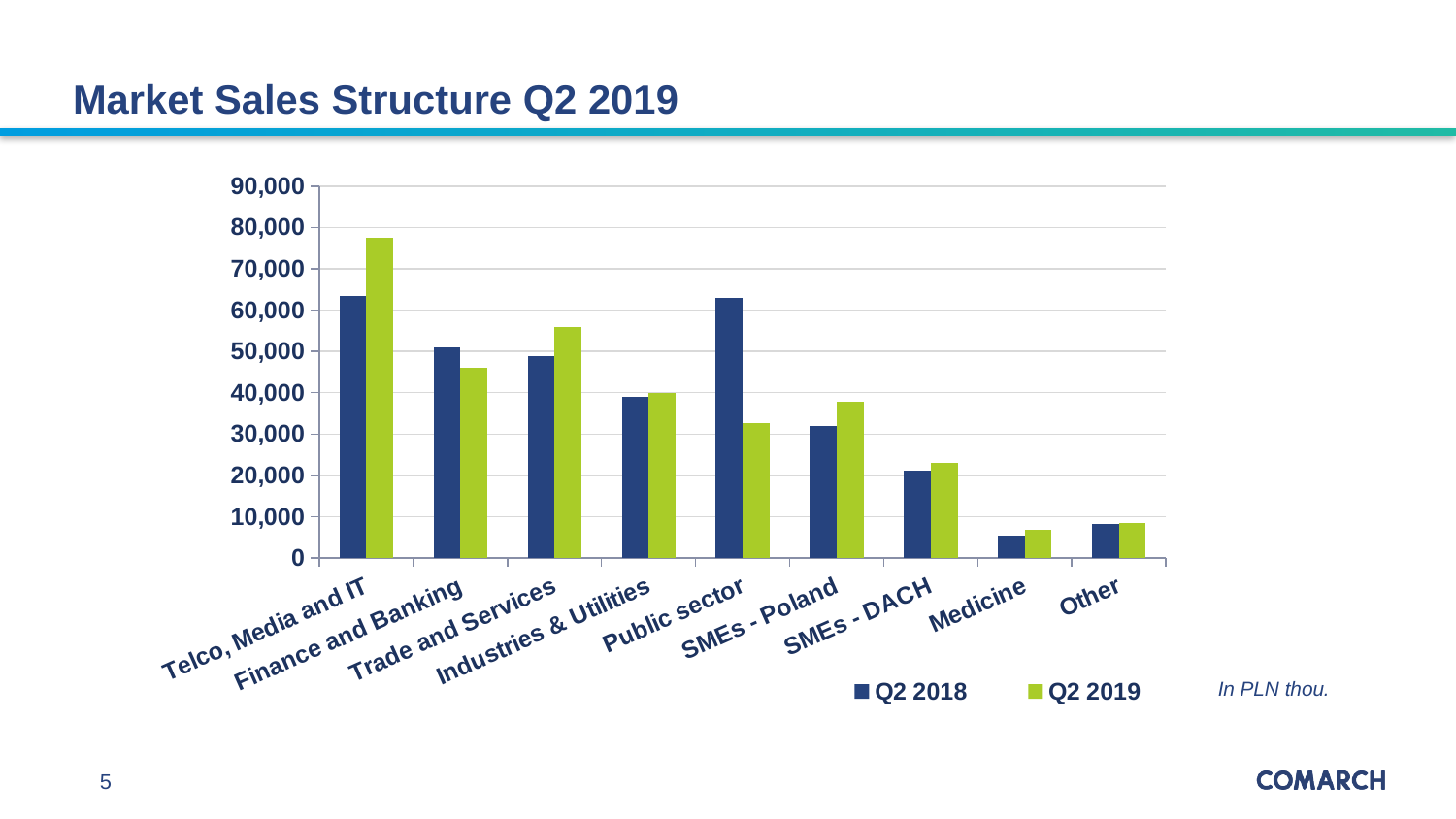
Which category has the highest Q2 2019 value? Telco, Media and IT In what unit are the values on the chart expressed, according to the note on the slide? PLN thou. Is the Q2 2018 value for Public sector greater or less than 60,000? greater For Public sector, which is larger: the Q2 2018 value or the Q2 2019 value? Q2 2018 Is the Q2 2019 value for Trade and Services greater or less than 50,000? greater Is the Q2 2019 value for Public sector greater or less than 40,000? less How many market categories are shown on the x axis? 9 How many series does the legend list? 2 What kind of chart is shown on the slide? bar chart Which category has the lowest Q2 2018 value? Medicine Which category has the lowest Q2 2019 value? Medicine